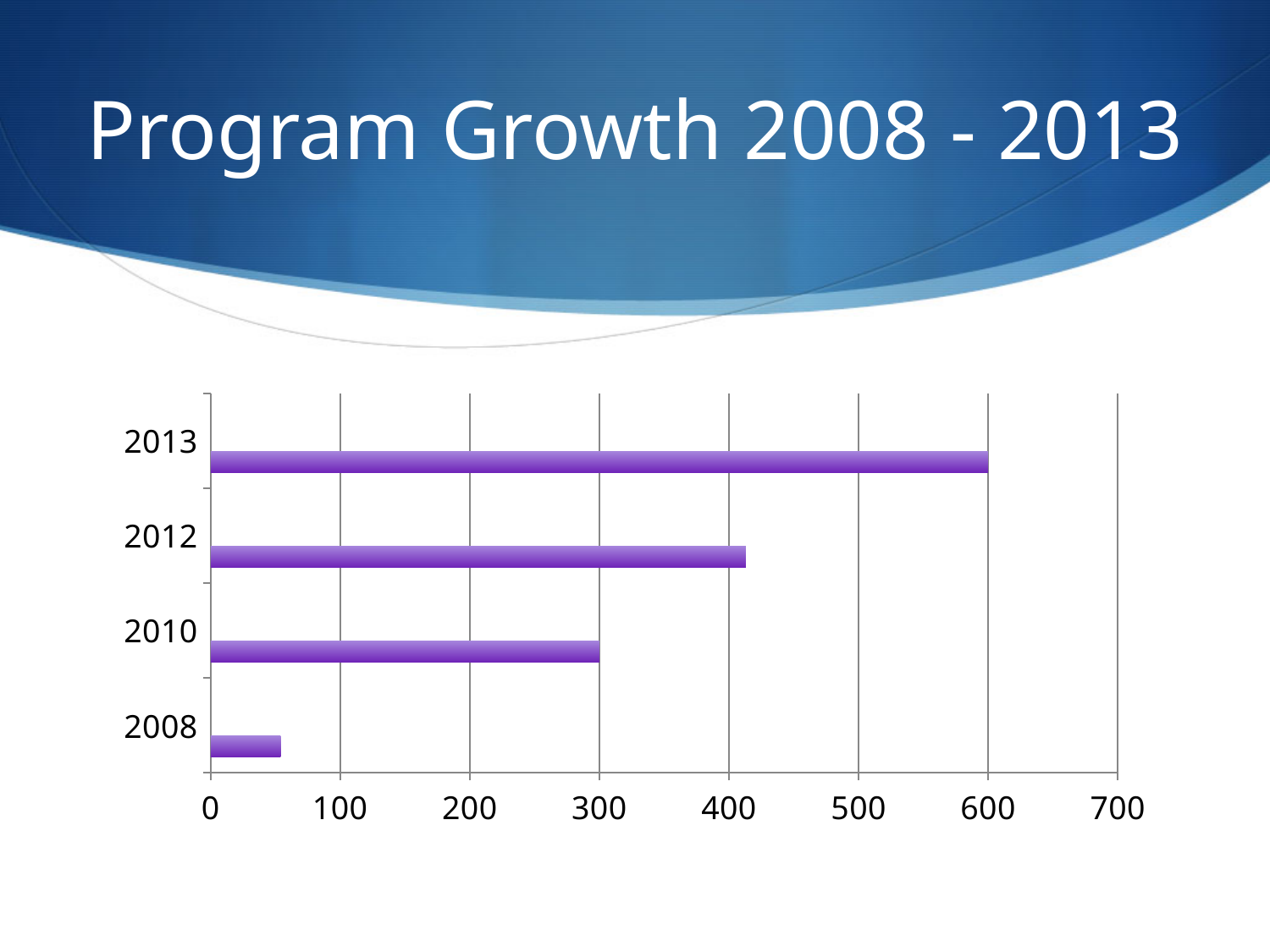
Is the value for 2012 greater or less than 400? greater Do the values rise or fall from 2008 to 2013? rise Is the value for 2008 greater or less than 100? less What is the value for 2010? 300 Which year has the highest value in the chart? 2013 Which is larger, the value for 2013 or the value for 2012? 2013 What is the value for 2013? 600 How many years (categories) are plotted in the chart? 4 What kind of chart is shown on the slide? bar chart What is the difference between the values for 2013 and 2010? 300 What is the title of the chart on the slide? Program Growth 2008 - 2013 Which year has the lowest value in the chart? 2008